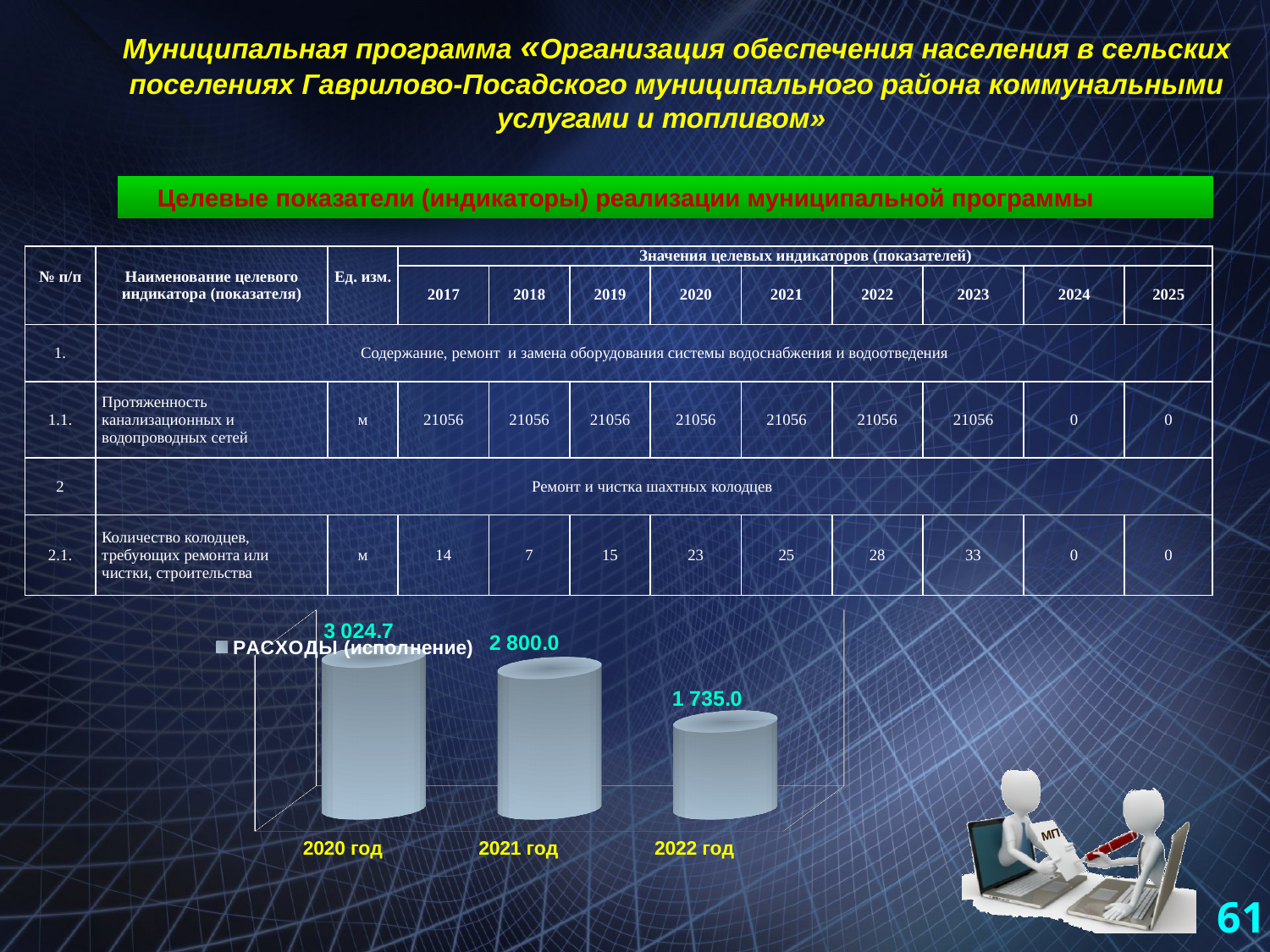
Which year has the highest value in the chart? 2020 год Which year has the lowest value in the chart? 2022 год Which is larger, the value for 2021 год or the value for 2022 год? 2021 год What is the difference between the values for 2020 год and 2021 год? 224.7 What is the difference between the values for 2021 год and 2022 год? 1 065.0 What is the value for 2021 год in the chart? 2 800.0 What kind of chart is shown on the slide? bar chart What is the value for 2022 год in the chart? 1 735.0 How many series does the chart legend list? 1 What is the value for 2020 год in the chart? 3 024.7 Do the values rise or fall from 2020 год to 2022 год? fall How many years are shown in the chart? 3